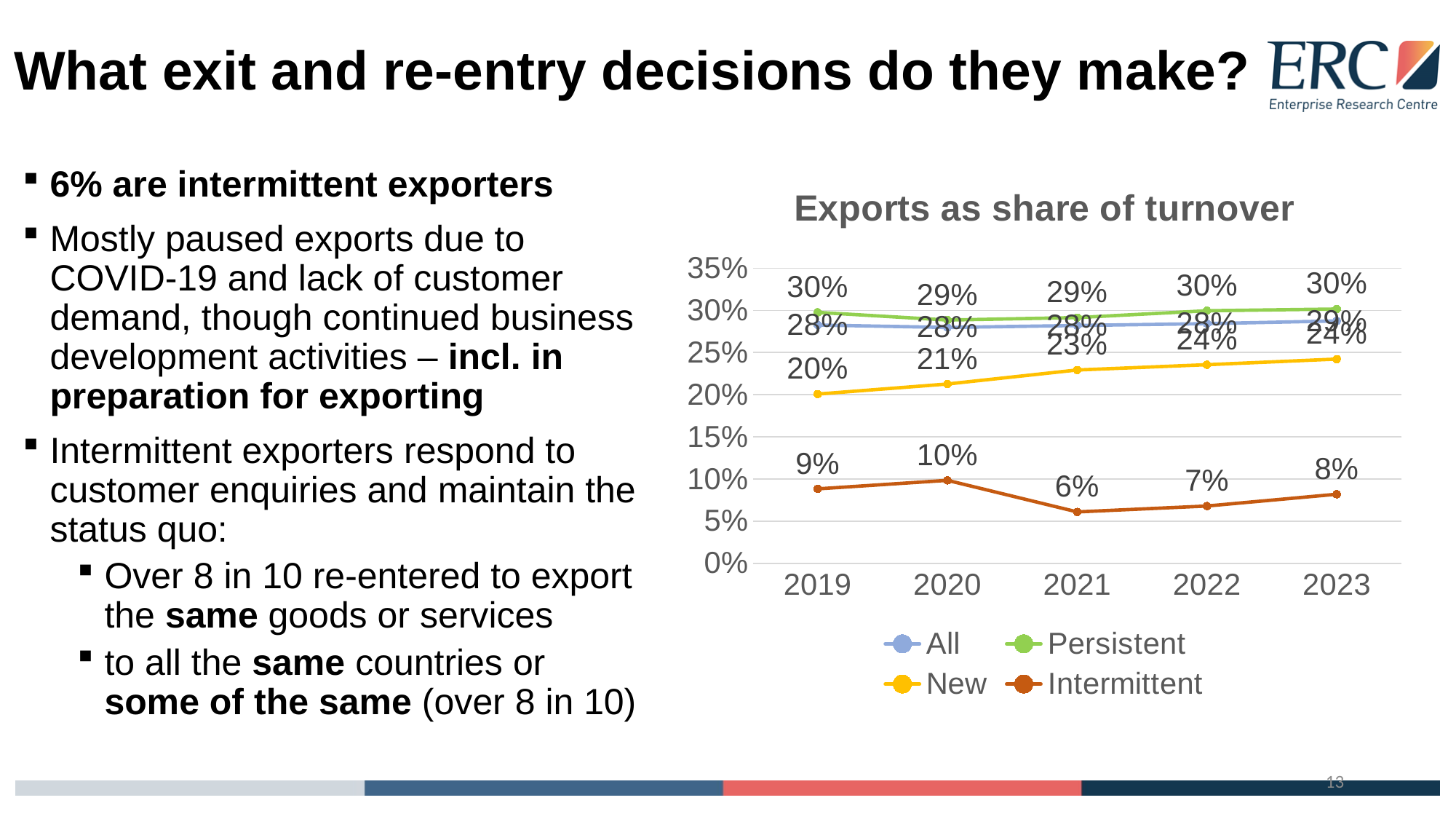
What is the title of the chart? Exports as share of turnover What kind of chart is shown on the slide? line chart How many years are shown on the x axis of the chart? 5 What is the difference between the New value in 2023 and the New value in 2019? 4% How many series does the chart legend list? 4 Does the New series rise or fall from 2019 to 2023? rise What is the value for Intermittent exporters in 2021? 6% What is the value for Persistent exporters in 2023? 30% Which series has the higher value in 2019, Persistent or New? Persistent In which year is the Intermittent series at its lowest? 2021 In which year is the Intermittent series at its highest? 2020 What is the value for New exporters in 2019? 20%